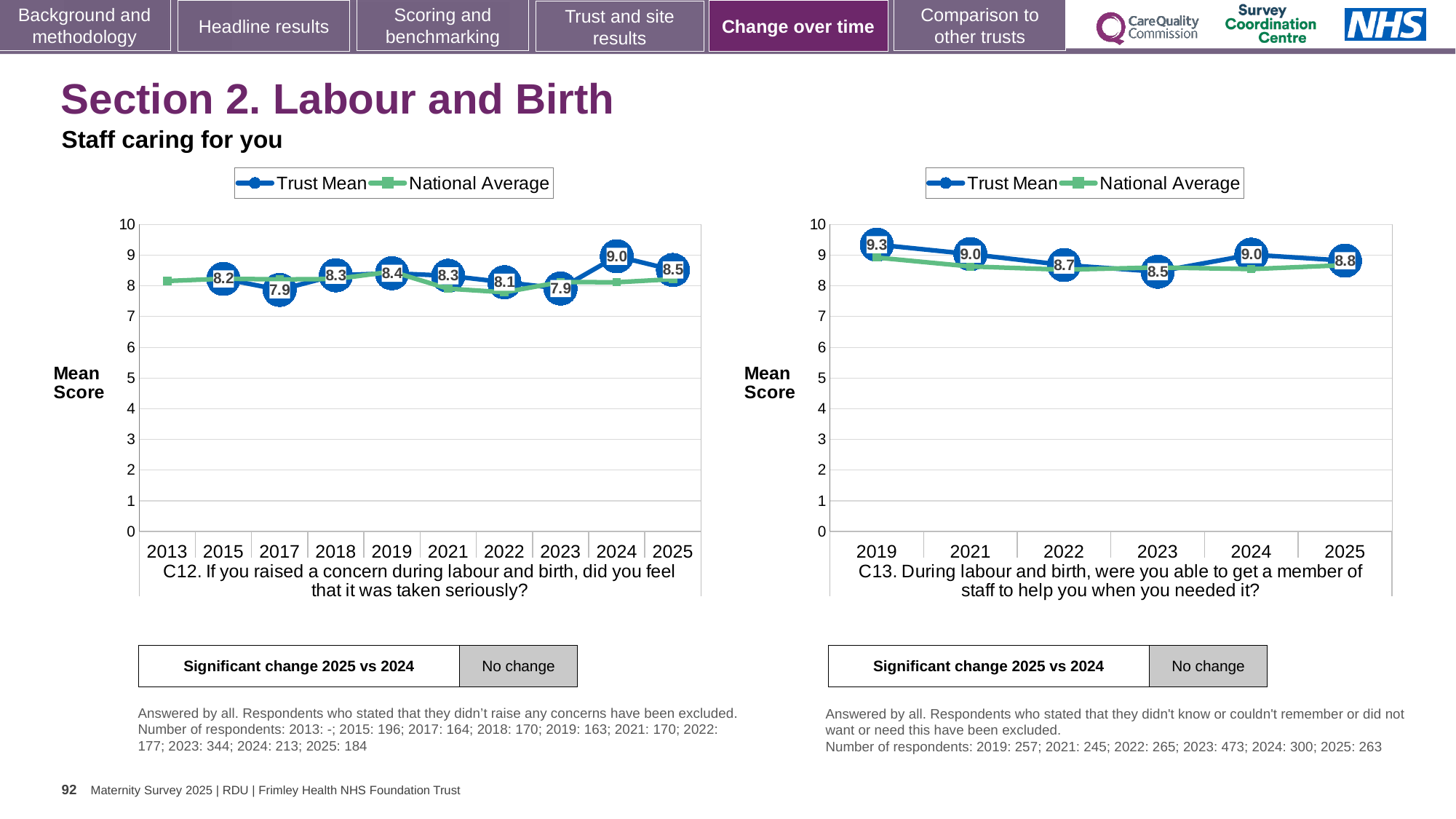
In the right chart (C13), what is the Trust Mean for 2019? 9.3 In the right chart (C13), what is the difference between the Trust Mean in 2019 and 2025? 0.5 In the left chart (C12), what is the Trust Mean for 2024? 9.0 What kind of chart is the right chart (C13)? Line chart In the right chart (C13), which year has the lowest Trust Mean? 2023 In the left chart (C12), how many series does the legend list? 2 In the left chart (C12), what is the difference between the Trust Mean in 2024 and 2025? 0.5 In the left chart (C12), which year has the highest Trust Mean? 2024 In the right chart (C13), is the Trust Mean for 2022 greater or less than 8? greater In the left chart (C12), what is the Trust Mean for 2025? 8.5 In the left chart (C12), how many years are shown on the x axis? 10 In the right chart (C13), is the Trust Mean for 2021 or 2023 larger? 2021